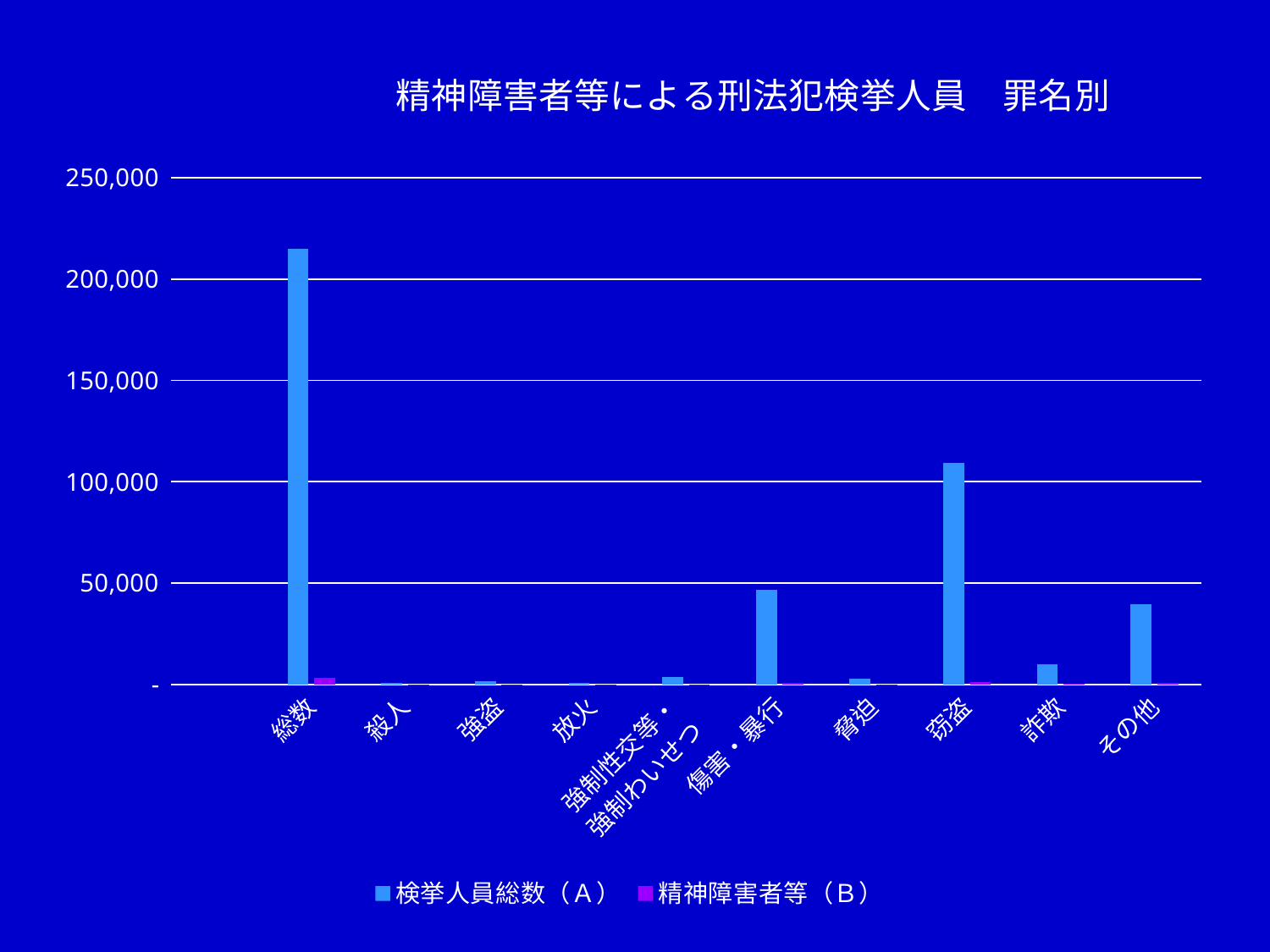
Which category has the highest value for 検挙人員総数（A）? 総数 How many categories are shown on the x axis of the chart? 10 Is the value of 検挙人員総数（A） for 詐欺 greater or less than 50,000? less Which series is shown in purple in the legend? 精神障害者等（B） Is the value of 検挙人員総数（A） for その他 greater or less than 50,000? less How many series does the legend list? 2 What kind of chart is shown on the slide? bar chart Is the value of 検挙人員総数（A） for 総数 greater or less than 200,000? greater Which is larger for 検挙人員総数（A）: 窃盗 or 傷害・暴行? 窃盗 Excluding 総数, which category has the highest value for 検挙人員総数（A）? 窃盗 What is the title of the chart? 精神障害者等による刑法犯検挙人員 罪名別